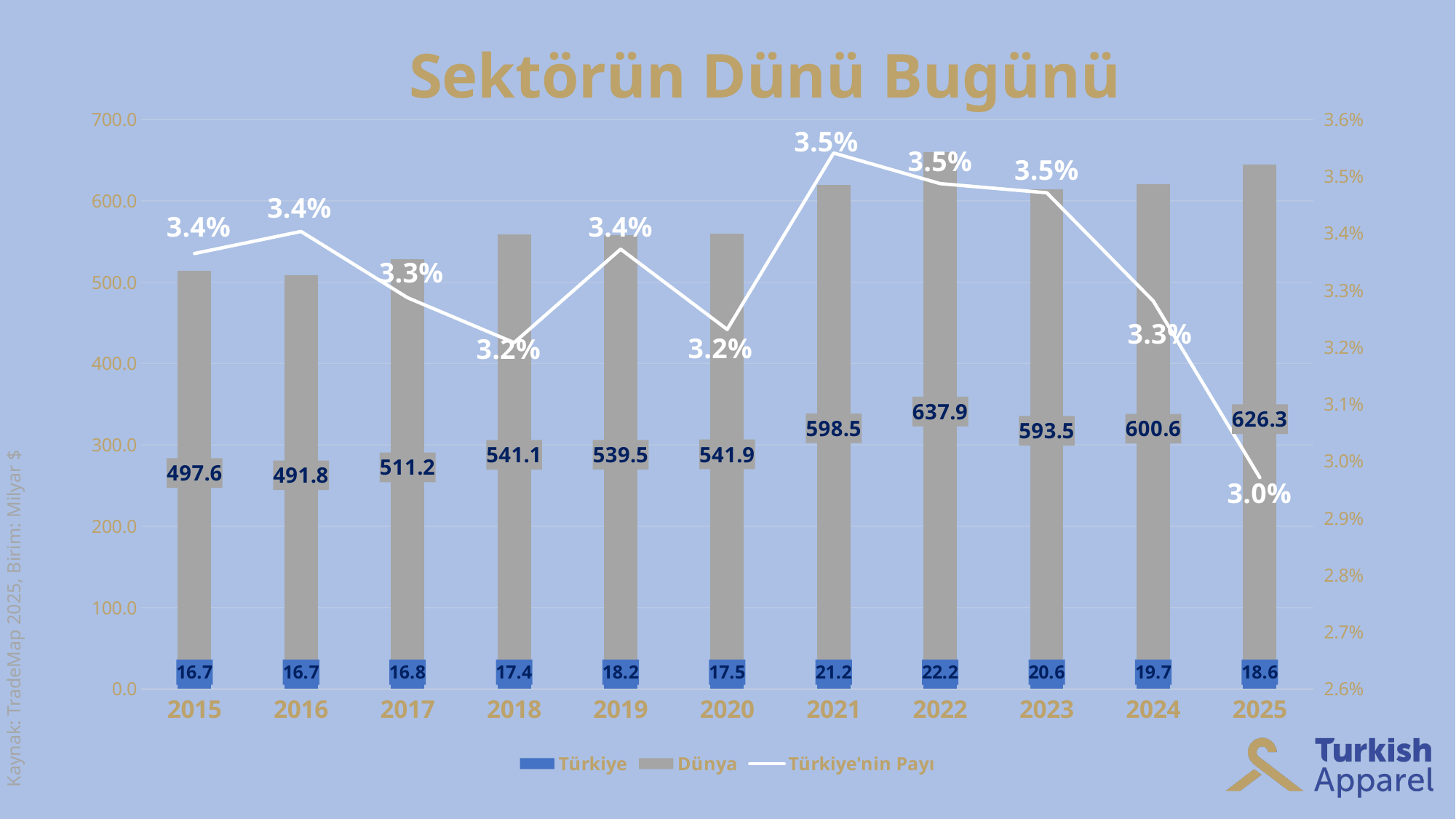
Which is larger, the Türkiye value for 2019 or for 2020? 2019 How many years are shown on the x axis? 11 What kind of chart is shown on the slide? Combined bar and line chart In which year is the Dünya value lowest? 2016 In which year is Türkiye'nin Payı lowest? 2025 In which year is the Dünya value highest? 2022 What is the title of the chart? Sektörün Dünü Bugünü What is the difference between the Dünya values for 2022 and 2015? 140.3 What is the Türkiye value for 2021? 21.2 What is Türkiye'nin Payı in 2025? 3.0% How many series does the legend list? 3 What is the Dünya value for 2022? 637.9